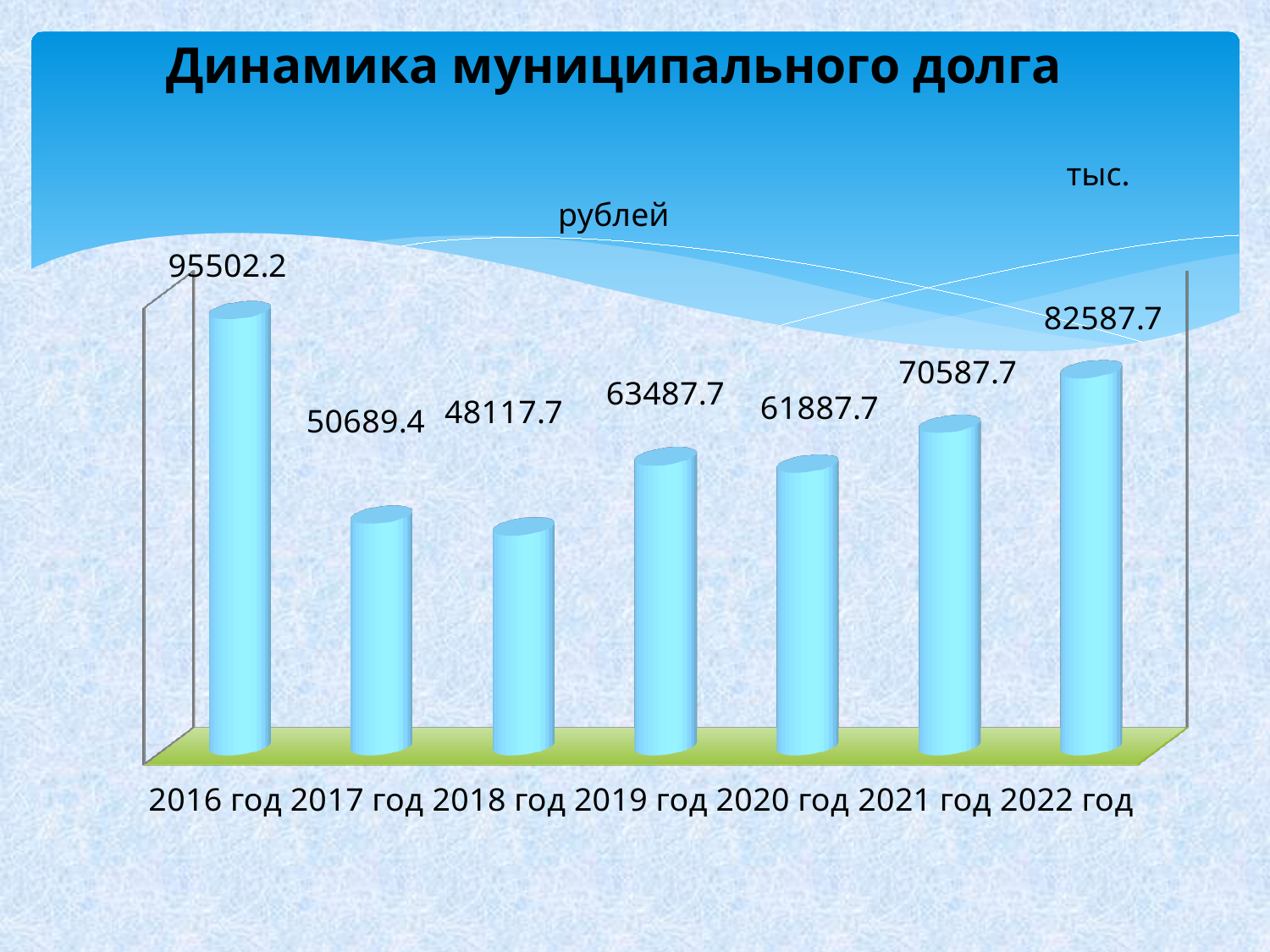
What is the title of the chart? Динамика муниципального долга What is the difference between the values for 2016 год and 2018 год? 47384.5 Which year has the lowest value? 2018 год What kind of chart is this? bar chart Which year has the highest value? 2016 год What is the value for 2019 год? 63487.7 What is the difference between the values for 2022 год and 2021 год? 12000 What is the value for 2022 год? 82587.7 Which is larger, the value for 2019 год or the value for 2020 год? 2019 год Do the values rise or fall from 2018 год to 2022 год? rise How many years are shown on the chart? 7 What is the value for 2016 год? 95502.2